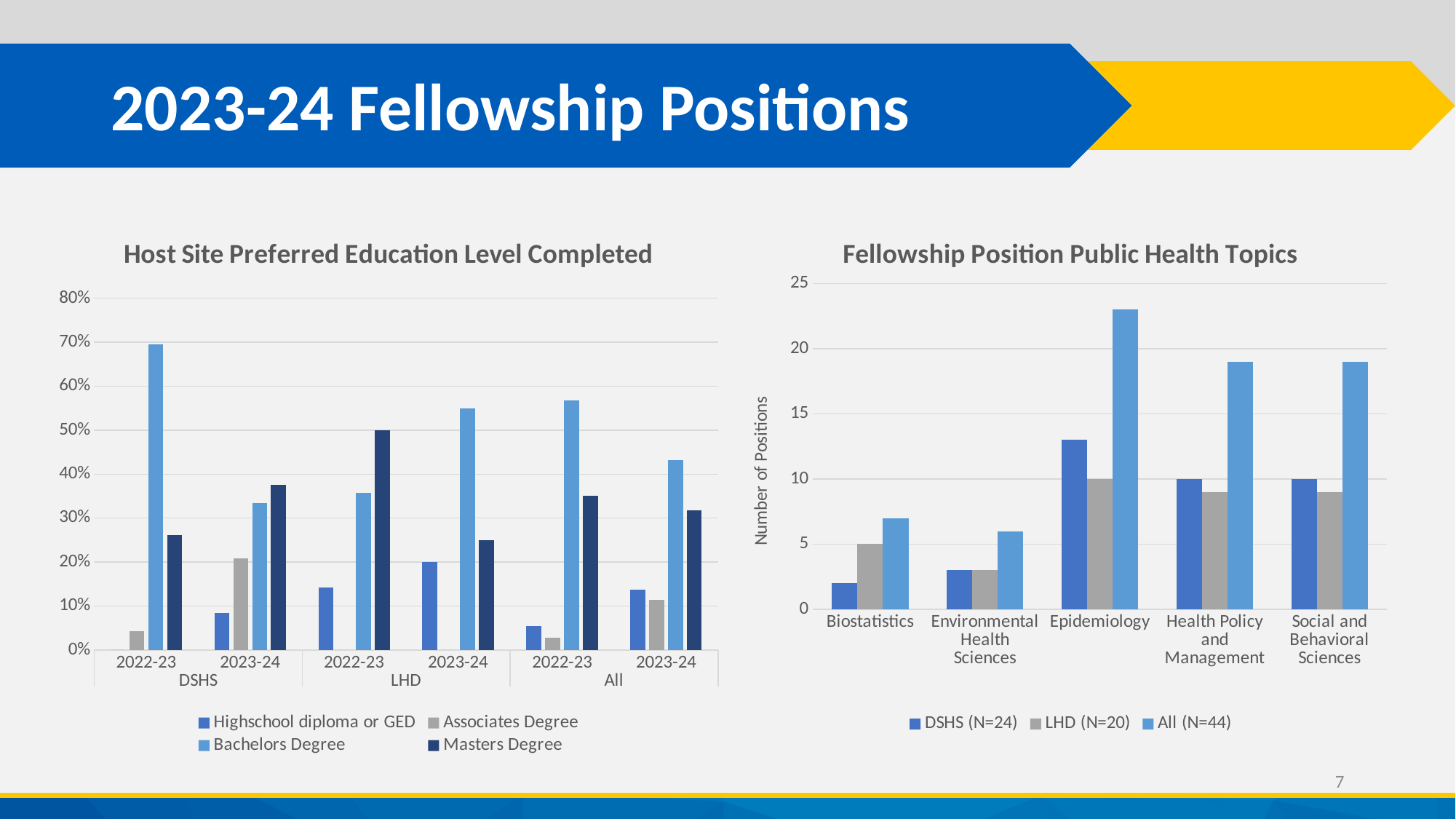
In the 'Host Site Preferred Education Level Completed' chart, which education level has the highest value for LHD 2022-23? Masters Degree In the 'Host Site Preferred Education Level Completed' chart, is the Bachelors Degree value for DSHS 2022-23 greater or less than 60%? greater In the 'Fellowship Position Public Health Topics' chart, is the All (N=44) value for Epidemiology greater or less than 20? greater In the 'Fellowship Position Public Health Topics' chart, which topic has the lowest value for DSHS (N=24)? Biostatistics How many series does the legend of the 'Host Site Preferred Education Level Completed' chart list? 4 How many public health topic categories are shown on the x axis of the 'Fellowship Position Public Health Topics' chart? 5 What is the y-axis title of the 'Fellowship Position Public Health Topics' chart? Number of Positions In the 'Host Site Preferred Education Level Completed' chart, which is larger for All 2022-23: Bachelors Degree or Masters Degree? Bachelors Degree In the 'Fellowship Position Public Health Topics' chart, which topic has the highest value for All (N=44)? Epidemiology In the 'Host Site Preferred Education Level Completed' chart, is the Masters Degree value for All 2023-24 greater or less than 40%? less How many series does the legend of the 'Fellowship Position Public Health Topics' chart list? 3 What kind of chart is the 'Host Site Preferred Education Level Completed' chart? bar chart